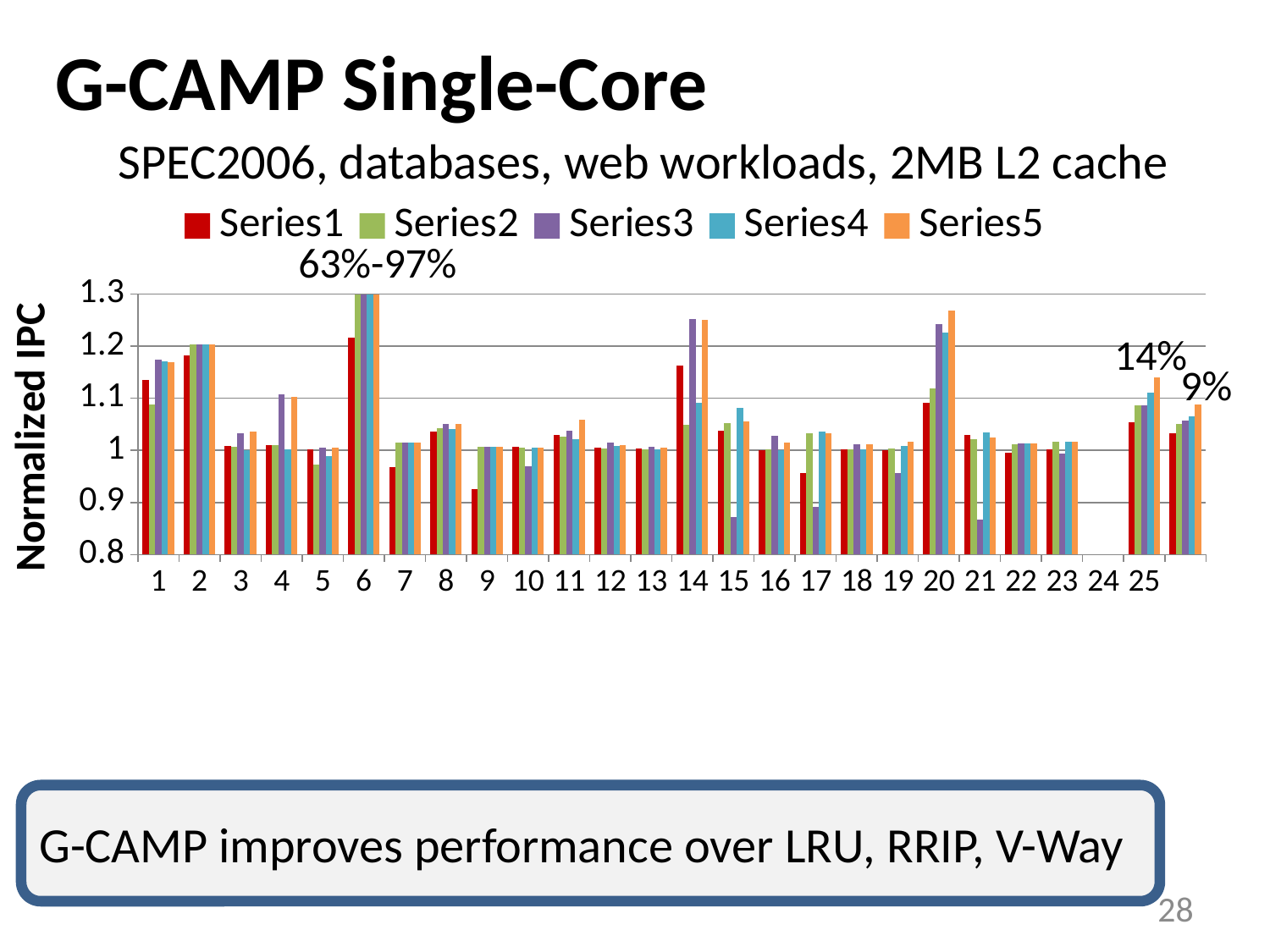
How many series does the legend list? 5 Which category has the highest Series1 value? 6 How many categories are labelled along the x axis? 25 What is the title of the y axis? Normalized IPC Is the Series3 value for category 14 greater or less than 1.2? greater For category 14, which is larger, the Series1 value or the Series3 value? Series3 For category 15, which is larger, the Series3 value or the Series4 value? Series4 Is the Series1 value for category 9 greater or less than 1? less What kind of chart is shown on the slide? bar chart What annotation is printed above the bars for category 6? 63%-97% Is the Series5 value for category 20 greater or less than 1.2? greater